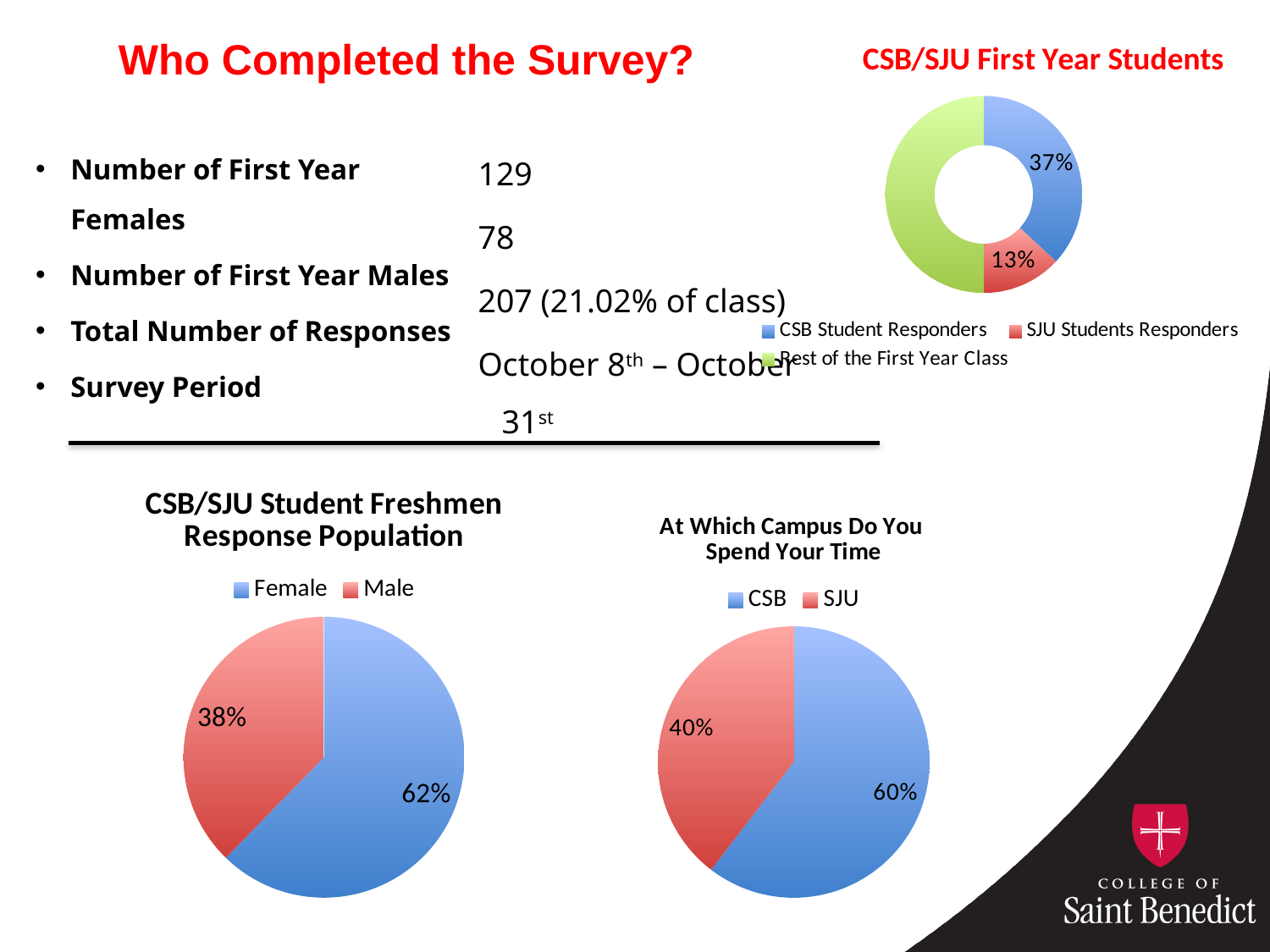
In the 'CSB/SJU Student Freshmen Response Population' chart, what percentage is Female? 62% In the 'CSB/SJU Student Freshmen Response Population' chart, what is the difference between the Female and Male shares? 24% How many series does the legend of the 'CSB/SJU First Year Students' chart list? 3 In the 'At Which Campus Do You Spend Your Time' chart, what percentage is CSB? 60% In the 'At Which Campus Do You Spend Your Time' chart, what percentage is SJU? 40% In the 'CSB/SJU First Year Students' chart, what percentage is SJU Students Responders? 13% In the 'At Which Campus Do You Spend Your Time' chart, which category is the largest? CSB In the 'CSB/SJU First Year Students' chart, what percentage is CSB Student Responders? 37% What kind of chart is the 'CSB/SJU Student Freshmen Response Population' chart? Pie chart In the 'CSB/SJU First Year Students' chart, what is the difference between CSB Student Responders and SJU Students Responders? 24% In the 'CSB/SJU First Year Students' chart, which is larger, CSB Student Responders or SJU Students Responders? CSB Student Responders In the 'CSB/SJU Student Freshmen Response Population' chart, what percentage is Male? 38%